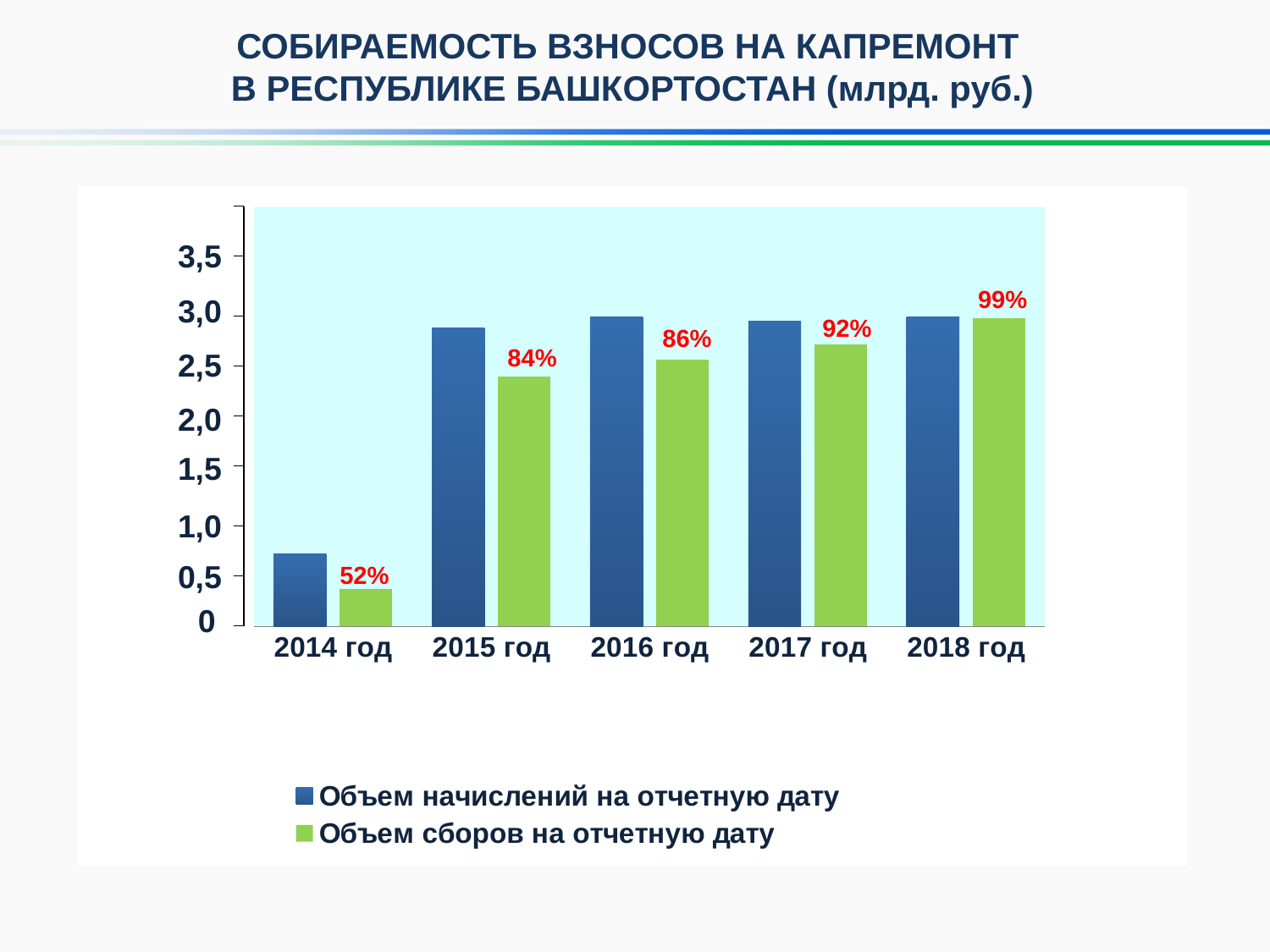
How many years (categories) are shown on the x axis of the chart? 5 What percentage label is shown above the 'Объем сборов на отчетную дату' bar for 2014 год? 52% Is the value of 'Объем сборов на отчетную дату' for 2015 год greater or less than 2,0? greater Which year has the highest value of 'Объем сборов на отчетную дату'? 2018 год What kind of chart is shown on the slide? bar chart Do the percentage labels on the 'Объем сборов на отчетную дату' bars rise or fall from 2014 год to 2018 год? rise What percentage label is shown above the 'Объем сборов на отчетную дату' bar for 2016 год? 86% What percentage label is shown above the 'Объем сборов на отчетную дату' bar for 2018 год? 99% Is the value of 'Объем начислений на отчетную дату' for 2014 год greater or less than 1,0? less Which is larger: 'Объем начислений на отчетную дату' for 2014 год or for 2015 год? 2015 год Which year has the lowest value of 'Объем начислений на отчетную дату'? 2014 год How many series does the chart legend list? 2